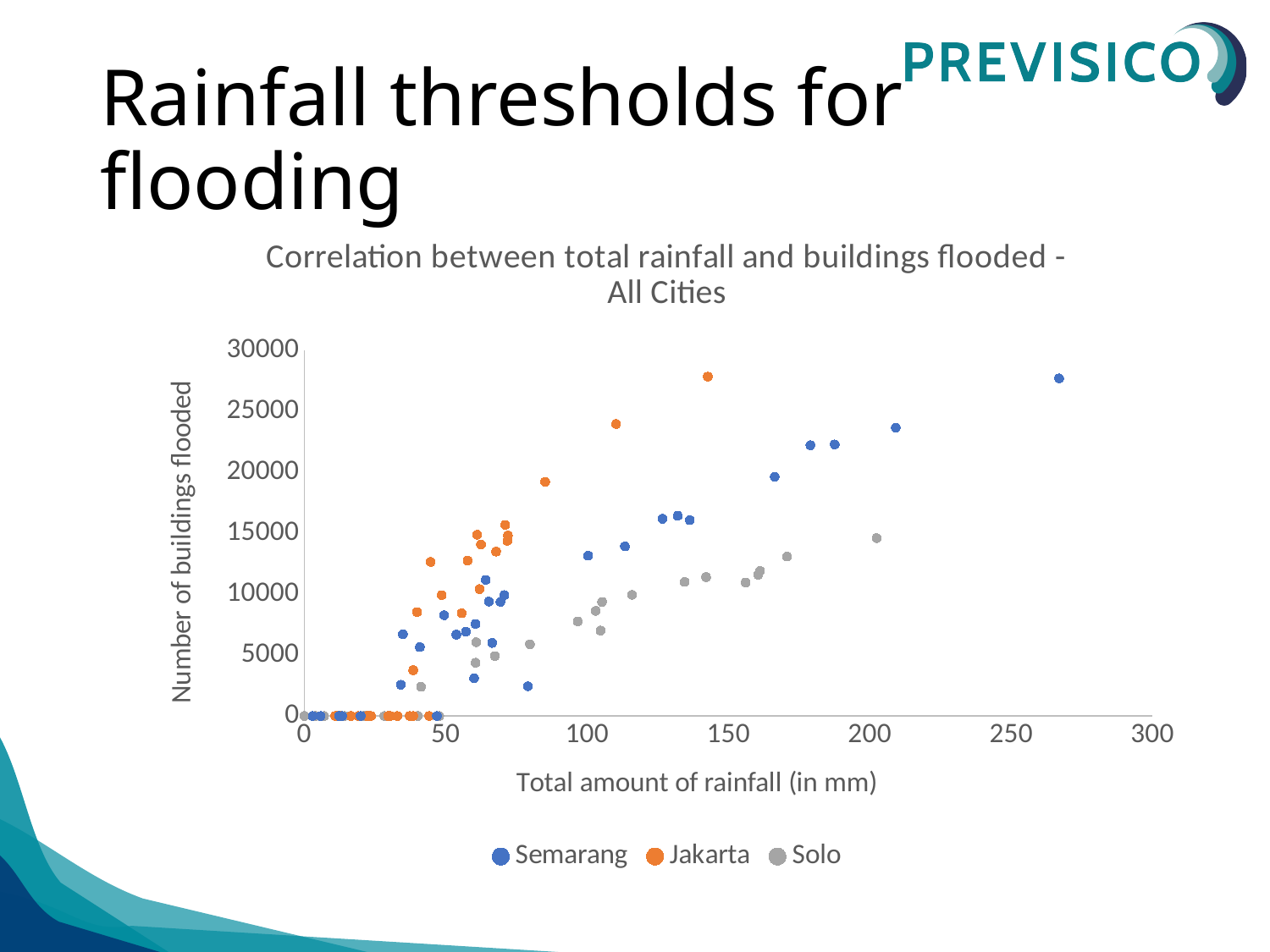
Is the highest Jakarta point greater or less than 25000 buildings flooded? greater What is the title of the chart? Correlation between total rainfall and buildings flooded - All Cities Is the highest Solo point greater or less than 20000 buildings flooded? less What is the label of the horizontal axis? Total amount of rainfall (in mm) What is the label of the vertical axis? Number of buildings flooded How many series does the legend list? 3 As total rainfall increases along the x axis, do the numbers of buildings flooded generally rise or fall? Rise Which series has the point with the largest total rainfall? Semarang Which series has the lowest maximum number of buildings flooded? Solo Is the Semarang point with the largest rainfall greater or less than 250 mm? greater What kind of chart is shown on the slide? Scatter chart